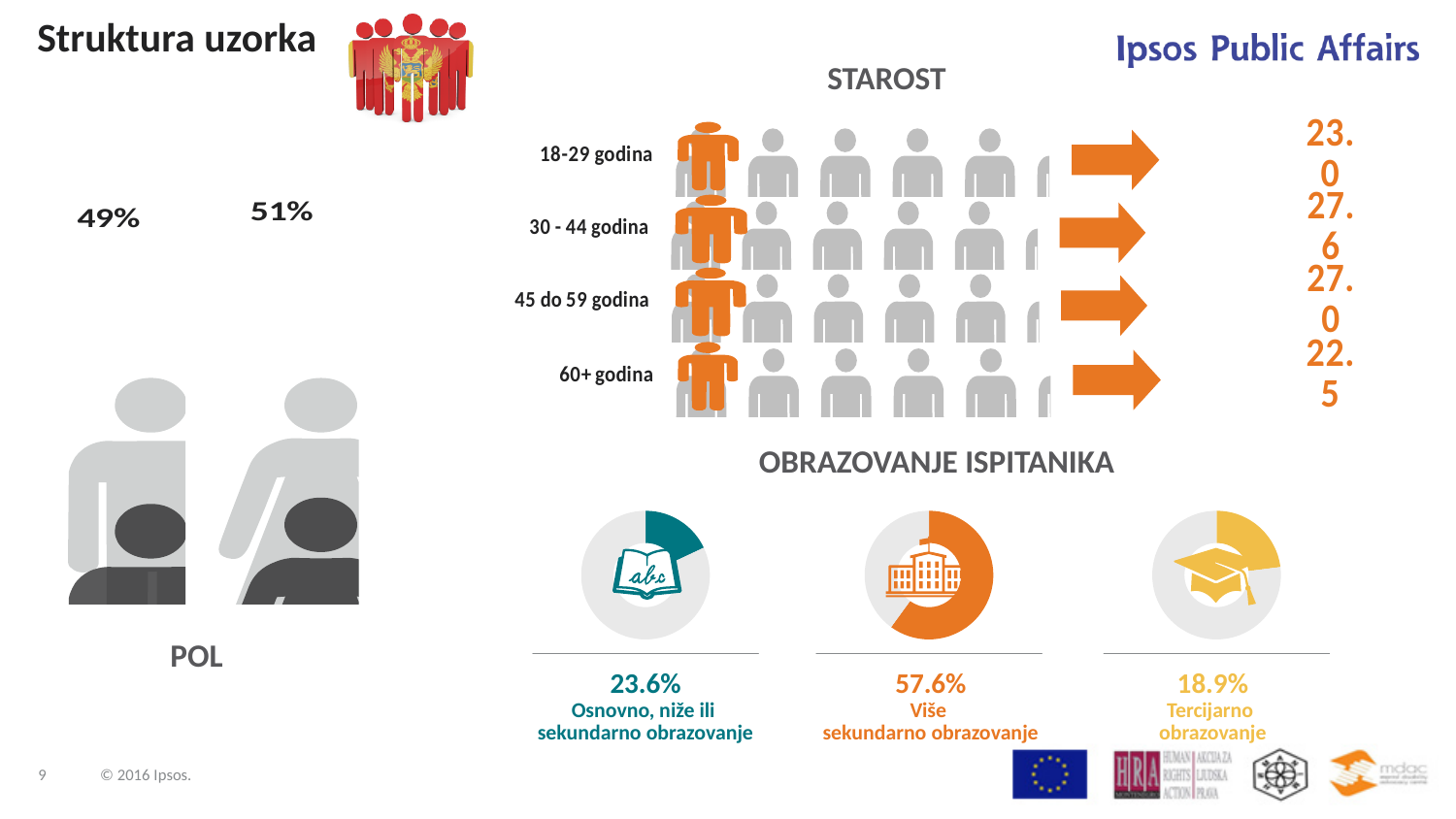
In the STAROST chart, what is the difference between the values for 45 do 59 godina and 60+ godina? 4.5 In the STAROST chart, what is the value for the 18-29 godina group? 23.0 In the STAROST chart, which age group has the highest value? 30 - 44 godina In the OBRAZOVANJE ISPITANIKA chart, which is larger: Osnovno, niže ili sekundarno obrazovanje or Tercijarno obrazovanje? Osnovno, niže ili sekundarno obrazovanje In the OBRAZOVANJE ISPITANIKA chart, what is the share for Tercijarno obrazovanje? 18.9% In the STAROST chart, what is the value for the 30 - 44 godina group? 27.6 In the OBRAZOVANJE ISPITANIKA chart, which education category has the largest share? Više sekundarno obrazovanje In the POL chart, what is the percentage shown for the left (male) figure? 49% In the OBRAZOVANJE ISPITANIKA chart, what is the share for Više sekundarno obrazovanje? 57.6% In the STAROST chart, which age group has the lowest value? 60+ godina In the STAROST chart, how many age groups are shown? 4 In the STAROST chart, what is the value for the 60+ godina group? 22.5